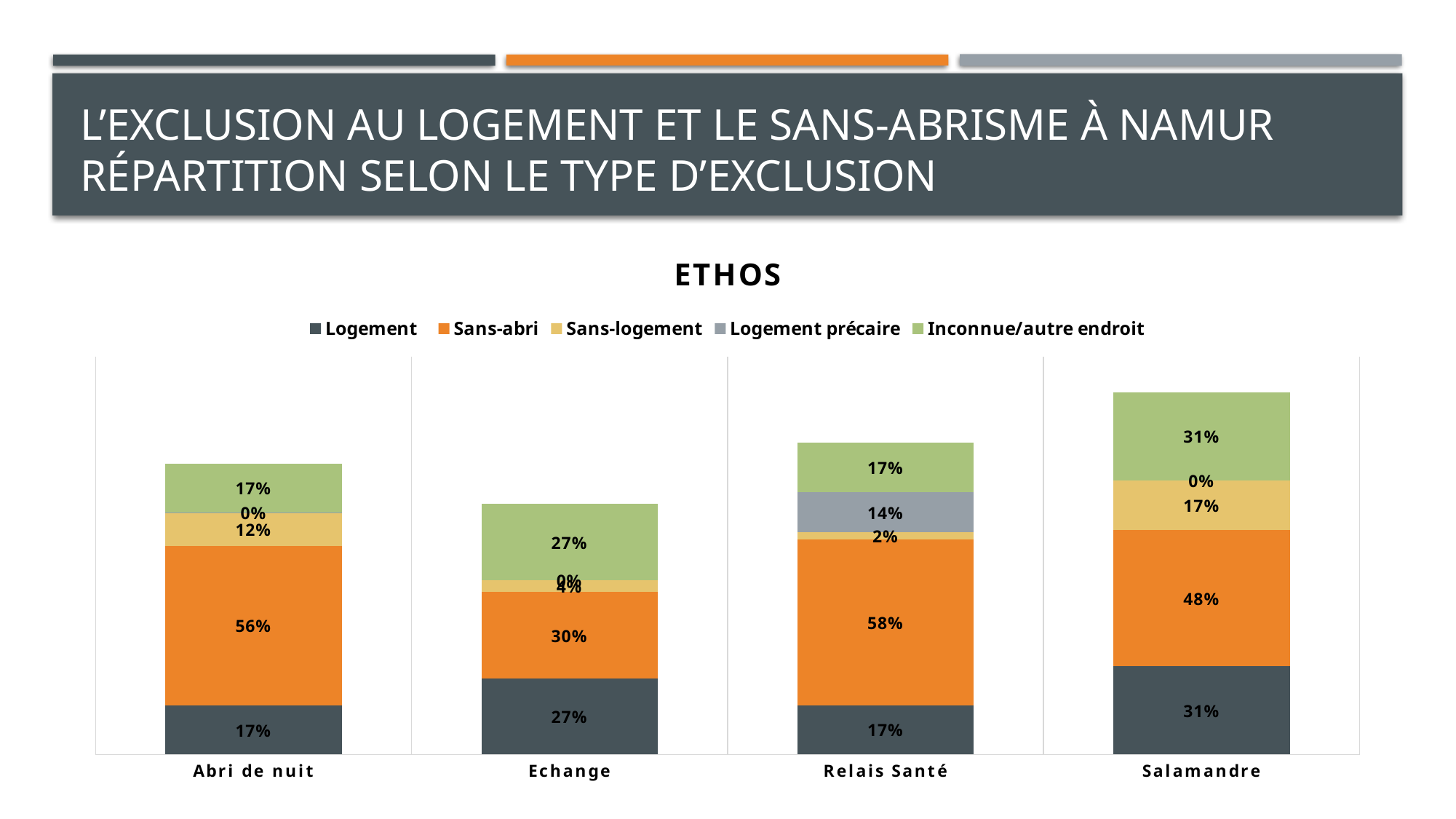
What is the Logement value for Echange? 27% Which category has the highest Sans-abri value? Relais Santé Which category has the lowest Sans-abri value? Echange What is the Sans-abri value for Abri de nuit? 56% What is the Logement précaire value for Relais Santé? 14% What is the difference between the Sans-abri values for Abri de nuit and Echange? 26 percentage points What is the Inconnue/autre endroit value for Salamandre? 31% How many series does the legend list? 5 Which is larger, the Logement value for Salamandre or for Echange? Salamandre How many categories are shown on the x axis? 4 What is the title of the chart? ETHOS What kind of chart is shown? Stacked bar chart